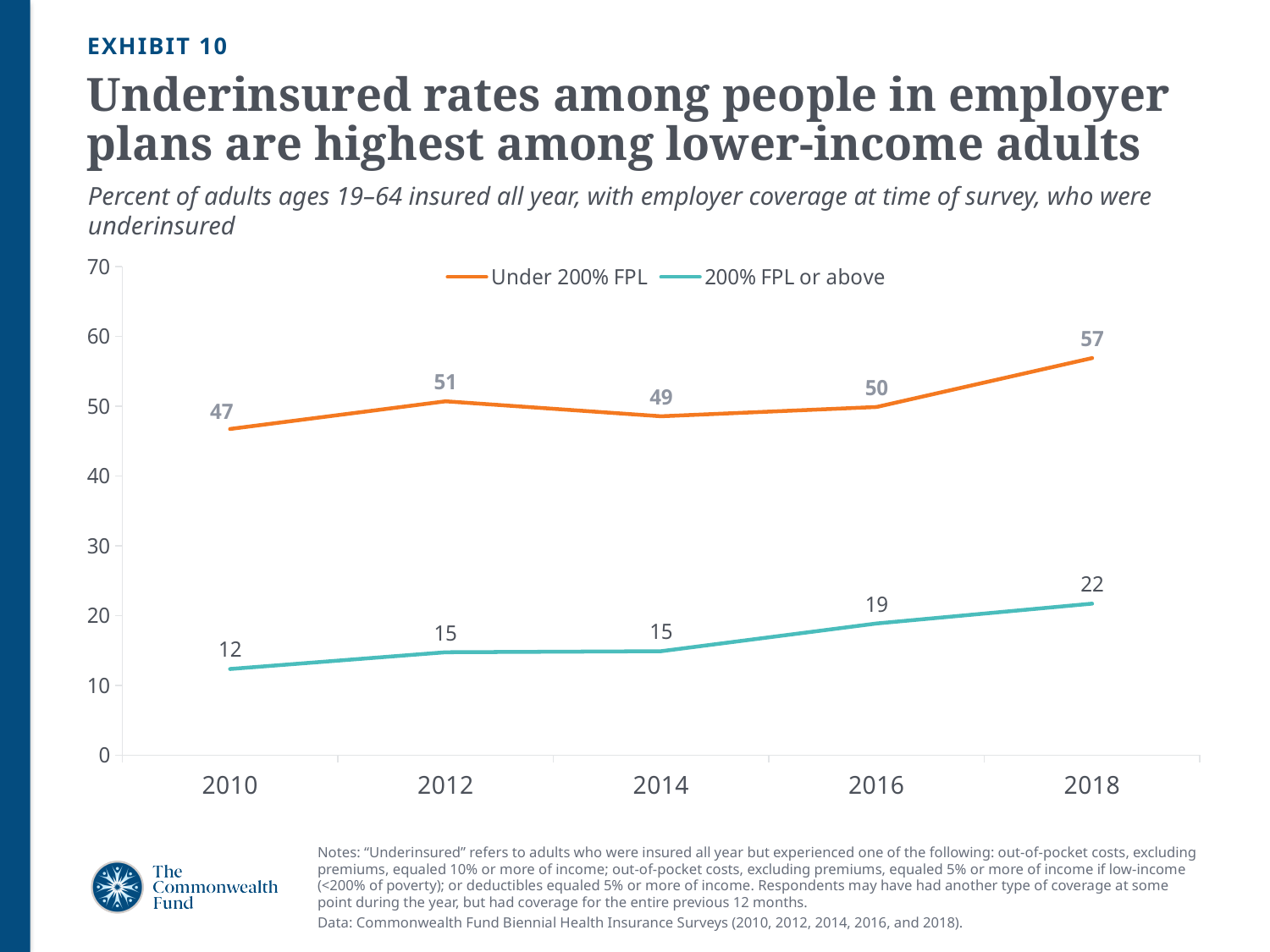
How many series does the legend list? 2 In which year is the Under 200% FPL series highest? 2018 What is the value for Under 200% FPL in 2018? 57 Is the value for Under 200% FPL in 2010 greater or less than 40? greater What is the value for Under 200% FPL in 2014? 49 How many years are plotted on the x axis? 5 What is the difference between the Under 200% FPL and 200% FPL or above values in 2016? 31 Does the 200% FPL or above series rise or fall from 2010 to 2018? Rise Which series has the larger value in 2012, Under 200% FPL or 200% FPL or above? Under 200% FPL What is the value for 200% FPL or above in 2010? 12 In which year is the 200% FPL or above series lowest? 2010 What kind of chart is shown on the slide? Line chart